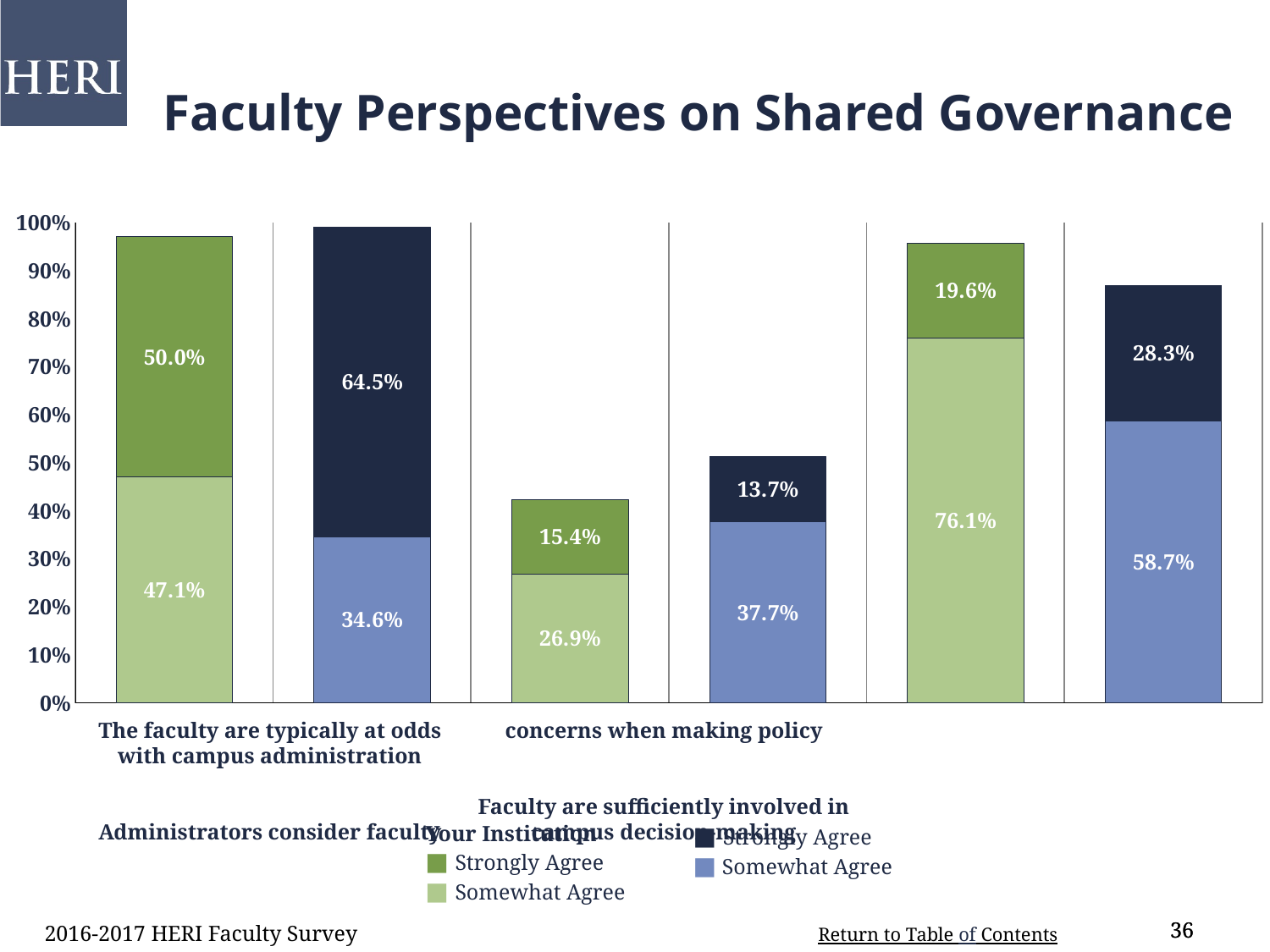
What is the title of the slide? Faculty Perspectives on Shared Governance What is the 'Strongly Agree' value for the green (Your Institution) bar for 'The faculty are typically at odds with campus administration'? 50.0% What is the 'Somewhat Agree' value for the green (Your Institution) bar for 'Faculty are sufficiently involved in campus decision making'? 76.1% What is the 'Somewhat Agree' value for the blue bar for 'The faculty are typically at odds with campus administration'? 34.6% What is the total of the blue stacked bar for 'Faculty are sufficiently involved in campus decision making'? 87.0% What is the total of the green (Your Institution) stacked bar for 'Administrators consider faculty concerns when making policy'? 42.3% What type of chart is shown on the slide? Stacked bar chart What is the difference between the 'Strongly Agree' values of the blue bar (64.5%) and the green bar (50.0%) for 'The faculty are typically at odds with campus administration'? 14.5% Which is larger: the 'Somewhat Agree' value for the green bar (76.1%) or the blue bar (58.7%) for 'Faculty are sufficiently involved in campus decision making'? Green bar (76.1%) What is the total of the green (Your Institution) stacked bar for 'The faculty are typically at odds with campus administration'? 97.1% How many statements (category groups) are shown on the x axis? 3 What is the 'Strongly Agree' value for the blue bar for 'Administrators consider faculty concerns when making policy'? 13.7%